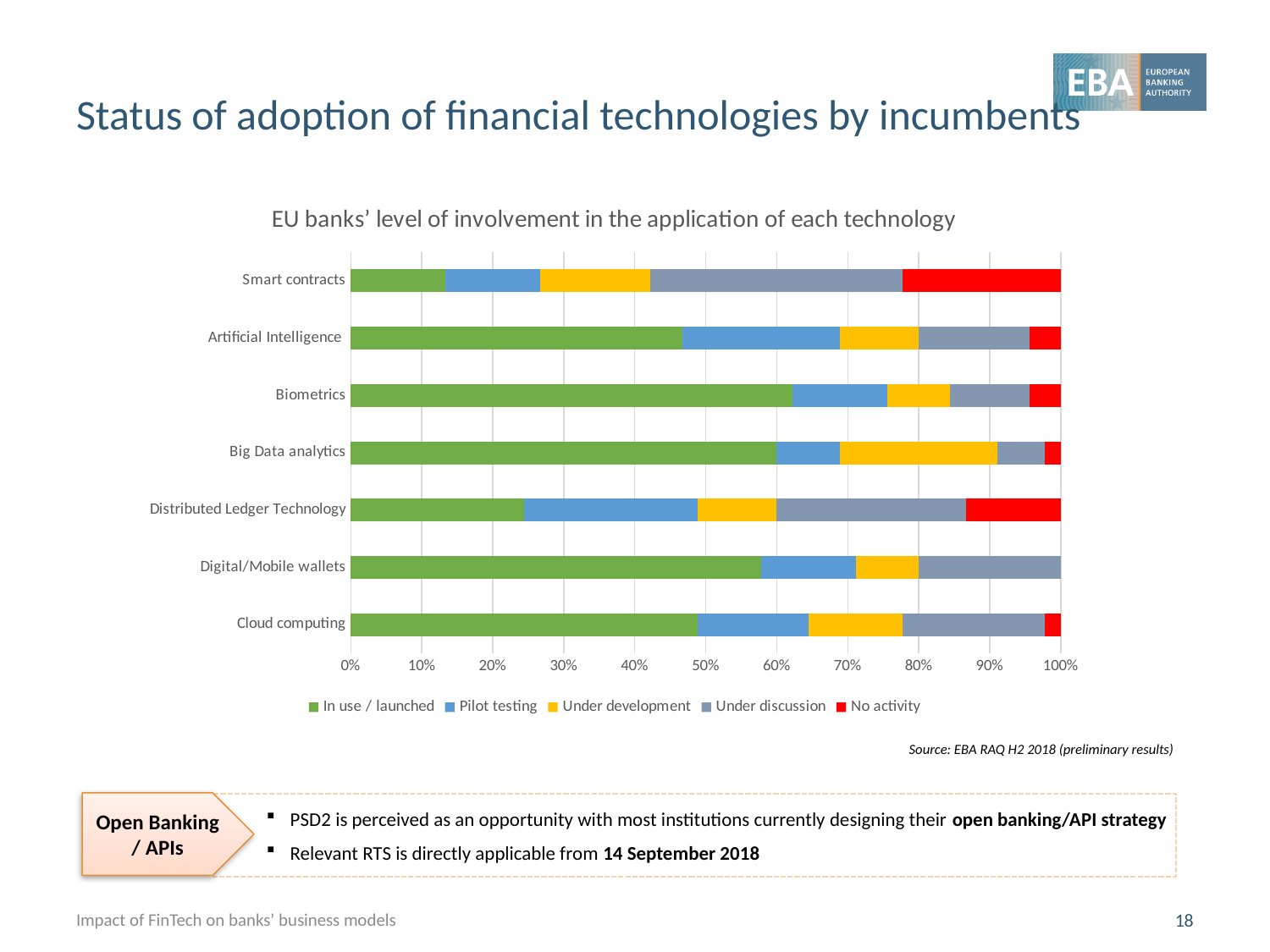
Is the 'In use / launched' share for Distributed Ledger Technology greater or less than 20%? greater What kind of chart is shown on the slide? Stacked bar chart What is the title of the chart? EU banks' level of involvement in the application of each technology How many technologies (categories) are listed on the chart? 7 Which technology has the largest 'No activity' share? Smart contracts Is the 'In use / launched' share for Smart contracts greater or less than 20%? less Which has a larger 'No activity' share: Smart contracts or Biometrics? Smart contracts Which has a larger 'In use / launched' share: Artificial Intelligence or Smart contracts? Artificial Intelligence How many series does the chart legend list? 5 Which technology shows no 'No activity' segment at all? Digital/Mobile wallets Is the 'In use / launched' share for Digital/Mobile wallets greater or less than 50%? greater Which technology has the smallest 'In use / launched' share? Smart contracts